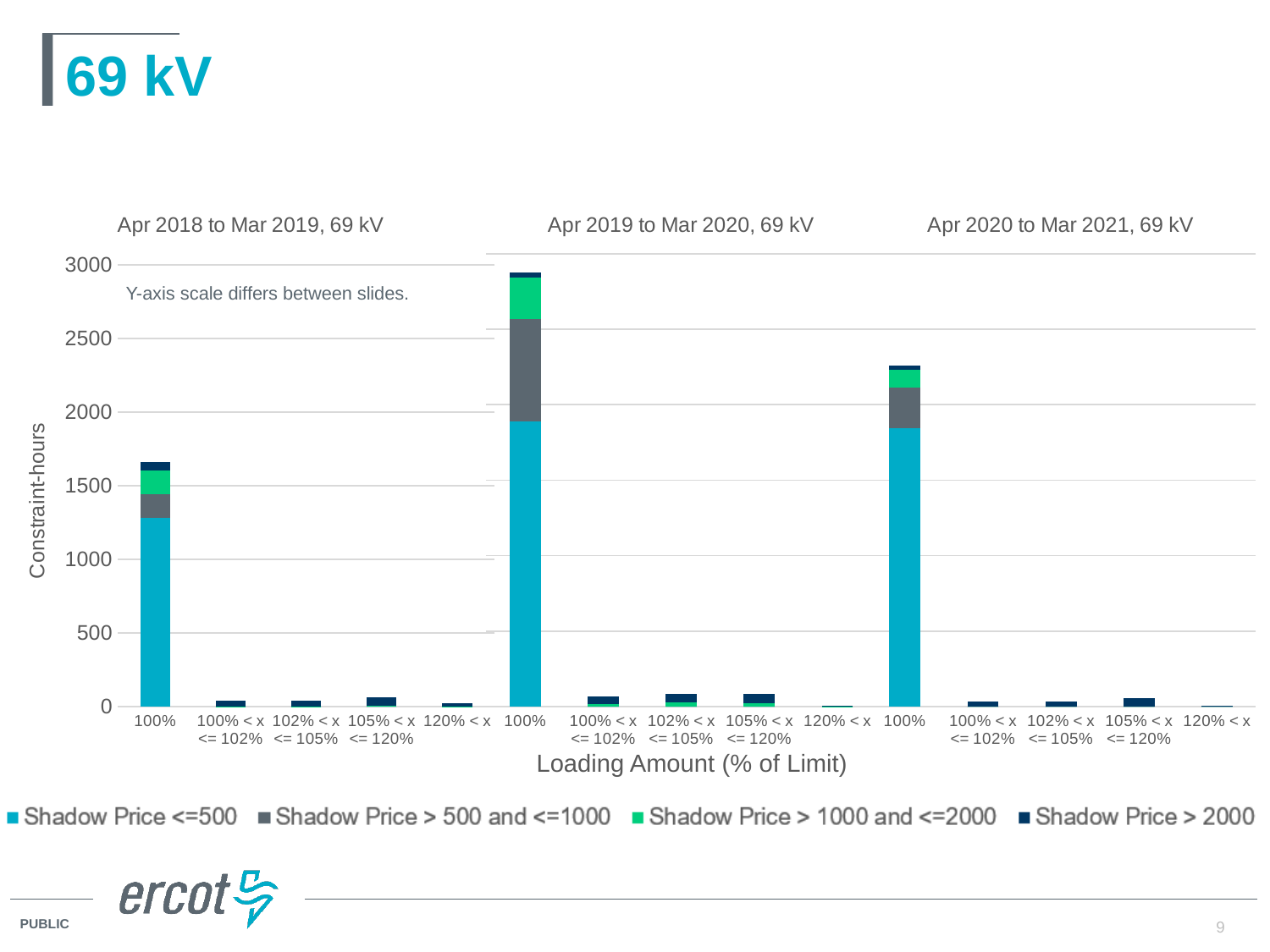
In the Apr 2018 to Mar 2019, 69 kV chart, which loading amount category has the lowest total constraint-hours? 120% < x In the Apr 2019 to Mar 2020, 69 kV chart, which loading amount category has the highest total constraint-hours? 100% What kind of chart is shown on the slide? Stacked bar chart Is the 100% bar taller in the Apr 2018 to Mar 2019, 69 kV chart or in the Apr 2020 to Mar 2021, 69 kV chart? Apr 2020 to Mar 2021, 69 kV How many series does the legend list? 4 In the Apr 2018 to Mar 2019, 69 kV chart, how many loading amount categories are shown on the x axis? 5 In the Apr 2020 to Mar 2021, 69 kV chart, is the total constraint-hours for the 100% category greater or less than 2000? greater In the Apr 2019 to Mar 2020, 69 kV chart, is the total constraint-hours for the 100% category greater or less than 2500? greater Which of the three periods has the tallest bar for the 100% loading category? Apr 2019 to Mar 2020, 69 kV What is the title of the x axis shared by the charts? Loading Amount (% of Limit) What is the label on the y axis of the charts? Constraint-hours In the Apr 2018 to Mar 2019, 69 kV chart, is the total constraint-hours for the 100% category greater or less than 2000? less